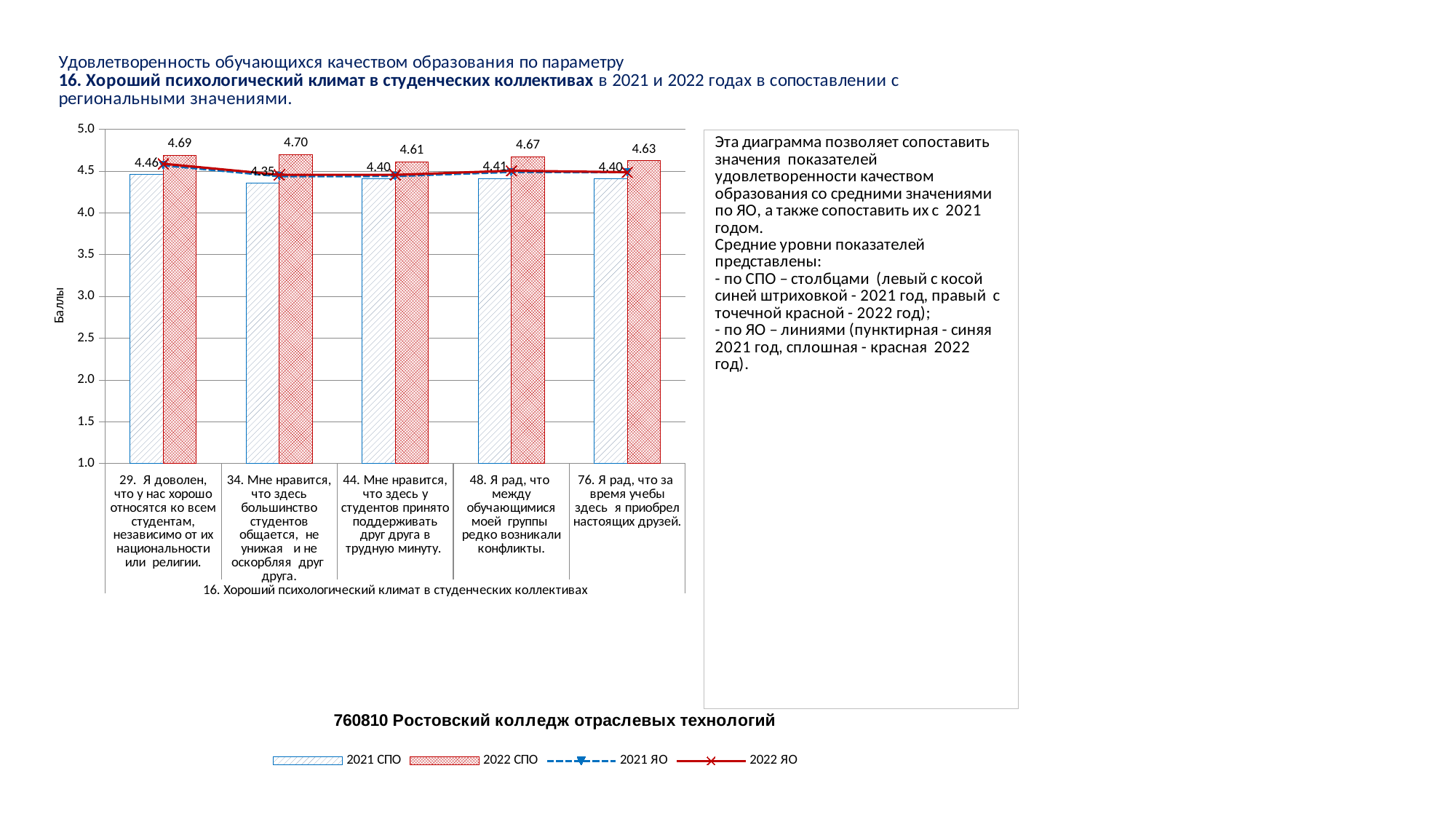
How many survey items (categories) are shown on the x axis? 5 What is the 2022 СПО value for item 76 ("Я рад, что за время учебы здесь я приобрел настоящих друзей")? 4.63 What is the difference between the 2022 СПО and 2021 СПО values for item 34? 0.35 What is the label of the vertical axis? Баллы What is the difference between the 2022 СПО and 2021 СПО values for item 48? 0.26 Is the 2021 СПО value for item 34 greater or less than 4.5? less Which item has the lowest 2021 СПО value? 34. Мне нравится, что здесь большинство студентов общается, не унижая и не оскорбляя друг друга. Which item has the highest 2022 СПО value? 34. Мне нравится, что здесь большинство студентов общается, не унижая и не оскорбляя друг друга. How many series does the legend list? 4 What is the 2022 СПО value for item 34 ("Мне нравится, что здесь большинство студентов общается, не унижая и не оскорбляя друг друга")? 4.70 What is the 2021 СПО value for item 29 ("Я доволен, что у нас хорошо относятся ко всем студентам, независимо от их национальности или религии")? 4.46 Which is larger for item 44: the 2021 СПО value or the 2022 СПО value? 2022 СПО